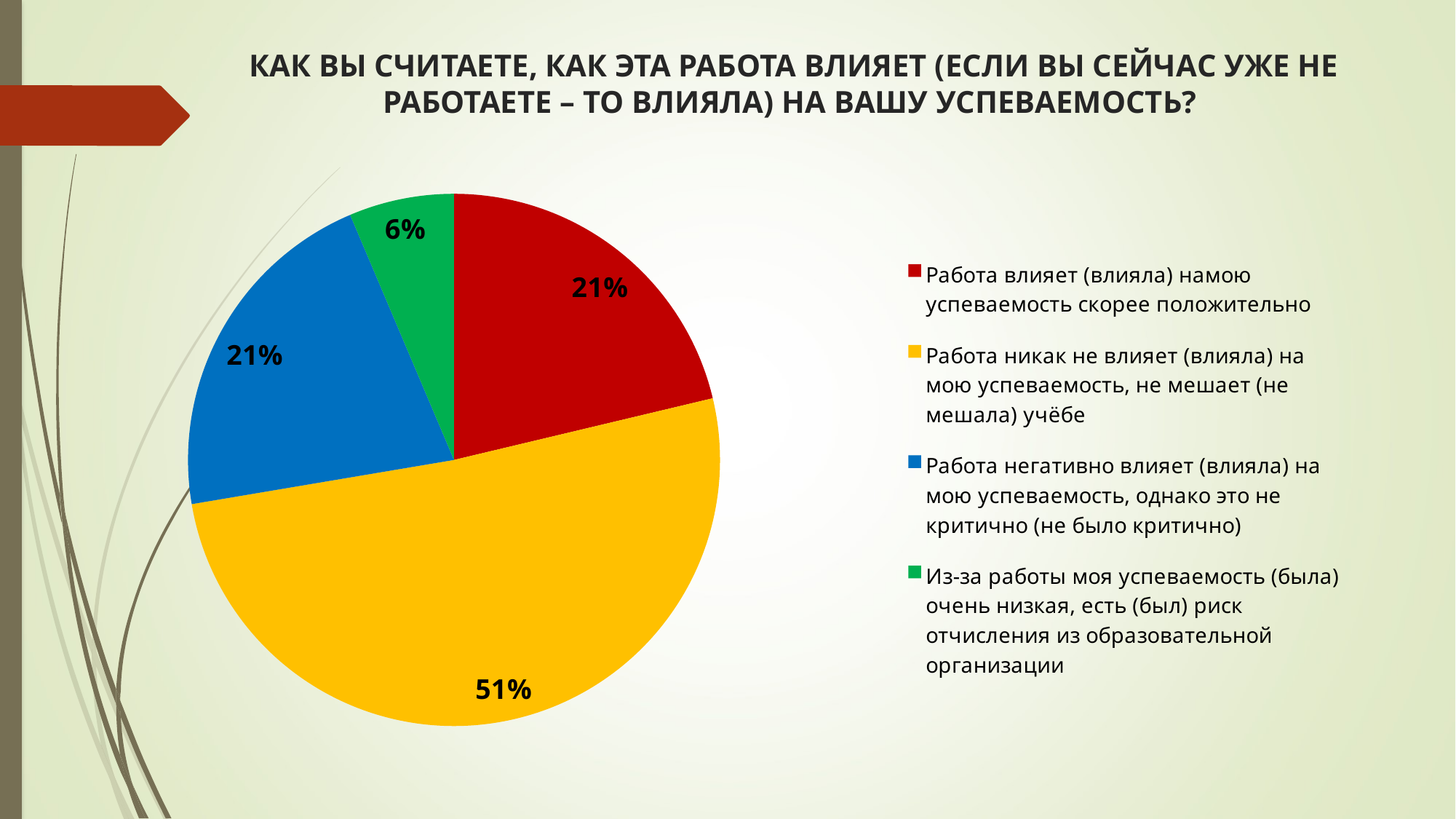
What share of respondents said their performance is very low due to work with a risk of expulsion ("Из-за работы моя успеваемость (была) очень низкая, есть (был) риск отчисления")? 6% What colour is the slice representing "Работа никак не влияет (влияла) на мою успеваемость"? yellow How many entries does the legend list? 4 What share of respondents said work does not affect their academic performance ("Работа никак не влияет (влияла) на мою успеваемость, не мешает (не мешала) учёбе")? 51% What type of chart is shown on the slide? pie chart How many slices does the pie chart have? 4 What share of respondents said work affects their performance rather positively ("Работа влияет (влияла) на мою успеваемость скорее положительно")? 21% Which response option has the largest share of the pie? Работа никак не влияет (влияла) на мою успеваемость, не мешает (не мешала) учёбе Which response option has the smallest share of the pie? Из-за работы моя успеваемость (была) очень низкая, есть (был) риск отчисления из образовательной организации What is the difference in percentage points between the "no influence" slice (51%) and the "risk of expulsion" slice (6%)? 45 Which is larger: the share for "Работа влияет (влияла) на мою успеваемость скорее положительно" or the share for "Из-за работы моя успеваемость (была) очень низкая"? Работа влияет (влияла) на мою успеваемость скорее положительно What share of respondents said work negatively affects their performance but not critically ("Работа негативно влияет (влияла) на мою успеваемость, однако это не критично")? 21%